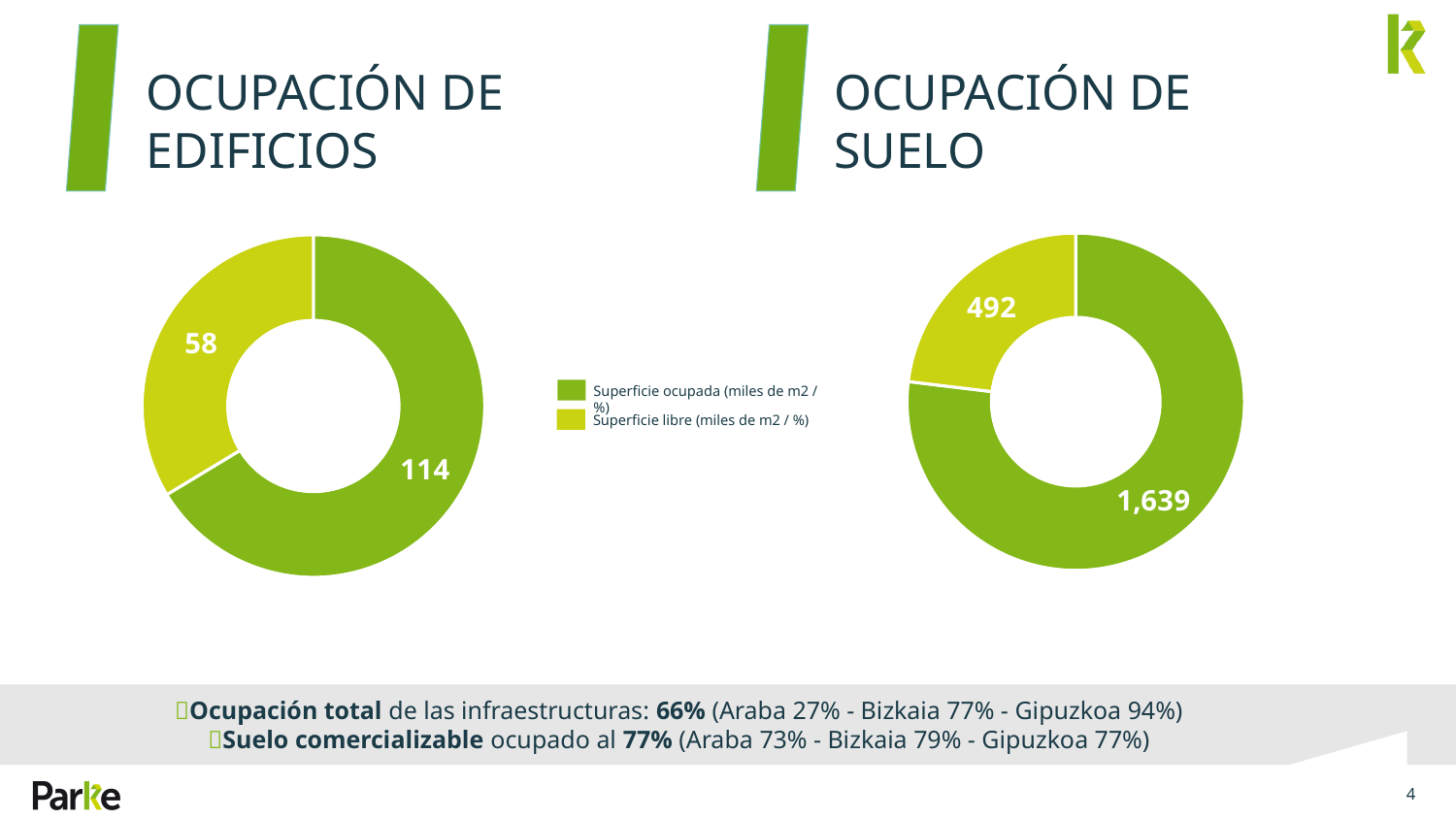
In the OCUPACIÓN DE EDIFICIOS chart, which slice is the largest? Superficie ocupada In the OCUPACIÓN DE EDIFICIOS chart, what is the value for Superficie libre? 58 In the OCUPACIÓN DE SUELO chart, what is the total of the two slices? 2,131 In the OCUPACIÓN DE EDIFICIOS chart, what is the difference between Superficie ocupada and Superficie libre? 56 In the OCUPACIÓN DE SUELO chart, which slice is the smallest? Superficie libre What kind of chart is used on the slide for OCUPACIÓN DE EDIFICIOS? Pie (donut) chart In the OCUPACIÓN DE SUELO chart, what is the value for Superficie libre? 492 In the OCUPACIÓN DE SUELO chart, what is the value for Superficie ocupada? 1,639 In the OCUPACIÓN DE EDIFICIOS chart, what is the value for Superficie ocupada? 114 How many entries does the legend between the two charts list? 2 In the OCUPACIÓN DE SUELO chart, what is the difference between Superficie ocupada and Superficie libre? 1,147 In the OCUPACIÓN DE EDIFICIOS chart, what share of the total does Superficie ocupada represent? 66%